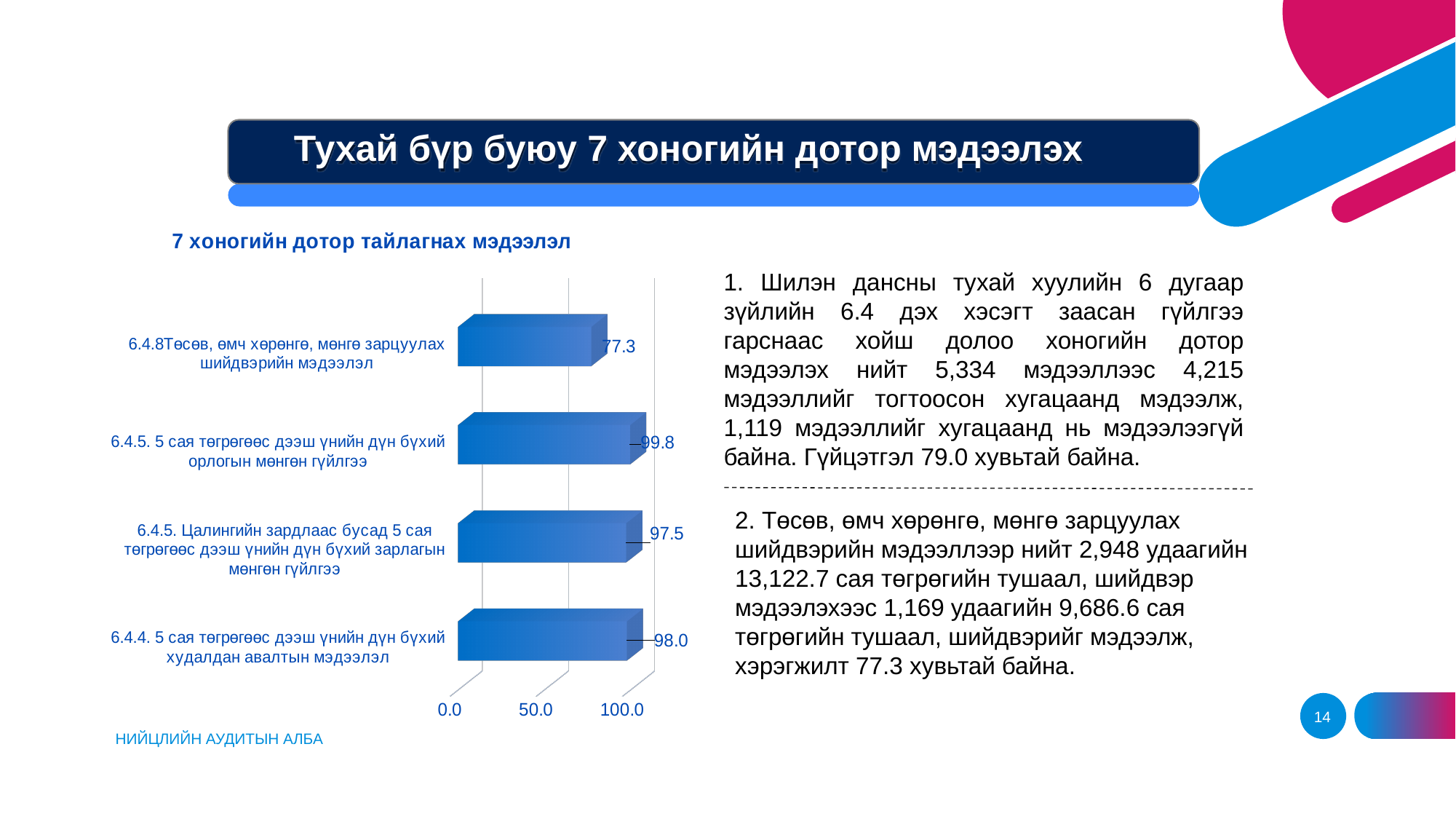
Which category has the highest value? 6.4.5. 5 сая төгрөгөөс дээш үнийн дүн бүхий орлогын мөнгөн гүйлгээ What is the value for "6.4.4. 5 сая төгрөгөөс дээш үнийн дүн бүхий худалдан авалтын мэдээлэл"? 98.0 What is the value for "6.4.5. Цалингийн зардлаас бусад 5 сая төгрөгөөс дээш үнийн дүн бүхий зарлагын мөнгөн гүйлгээ"? 97.5 Is the value for "6.4.8Төсөв, өмч хөрөнгө, мөнгө зарцуулах шийдвэрийн мэдээлэл" greater or less than 50.0? greater What is the difference between the highest value (99.8) and the lowest value (77.3)? 22.5 What type of chart is shown on the slide? bar chart Which category has the lowest value? 6.4.8Төсөв, өмч хөрөнгө, мөнгө зарцуулах шийдвэрийн мэдээлэл How many categories are plotted in the chart? 4 What is the chart's title? 7 хоногийн дотор тайлагнах мэдээлэл What is the value for "6.4.8Төсөв, өмч хөрөнгө, мөнгө зарцуулах шийдвэрийн мэдээлэл"? 77.3 Which is larger: the value for "6.4.4. 5 сая төгрөгөөс дээш үнийн дүн бүхий худалдан авалтын мэдээлэл" or the value for "6.4.5. Цалингийн зардлаас бусад 5 сая төгрөгөөс дээш үнийн дүн бүхий зарлагын мөнгөн гүйлгээ"? 6.4.4. 5 сая төгрөгөөс дээш үнийн дүн бүхий худалдан авалтын мэдээлэл What is the value for "6.4.5. 5 сая төгрөгөөс дээш үнийн дүн бүхий орлогын мөнгөн гүйлгээ"? 99.8